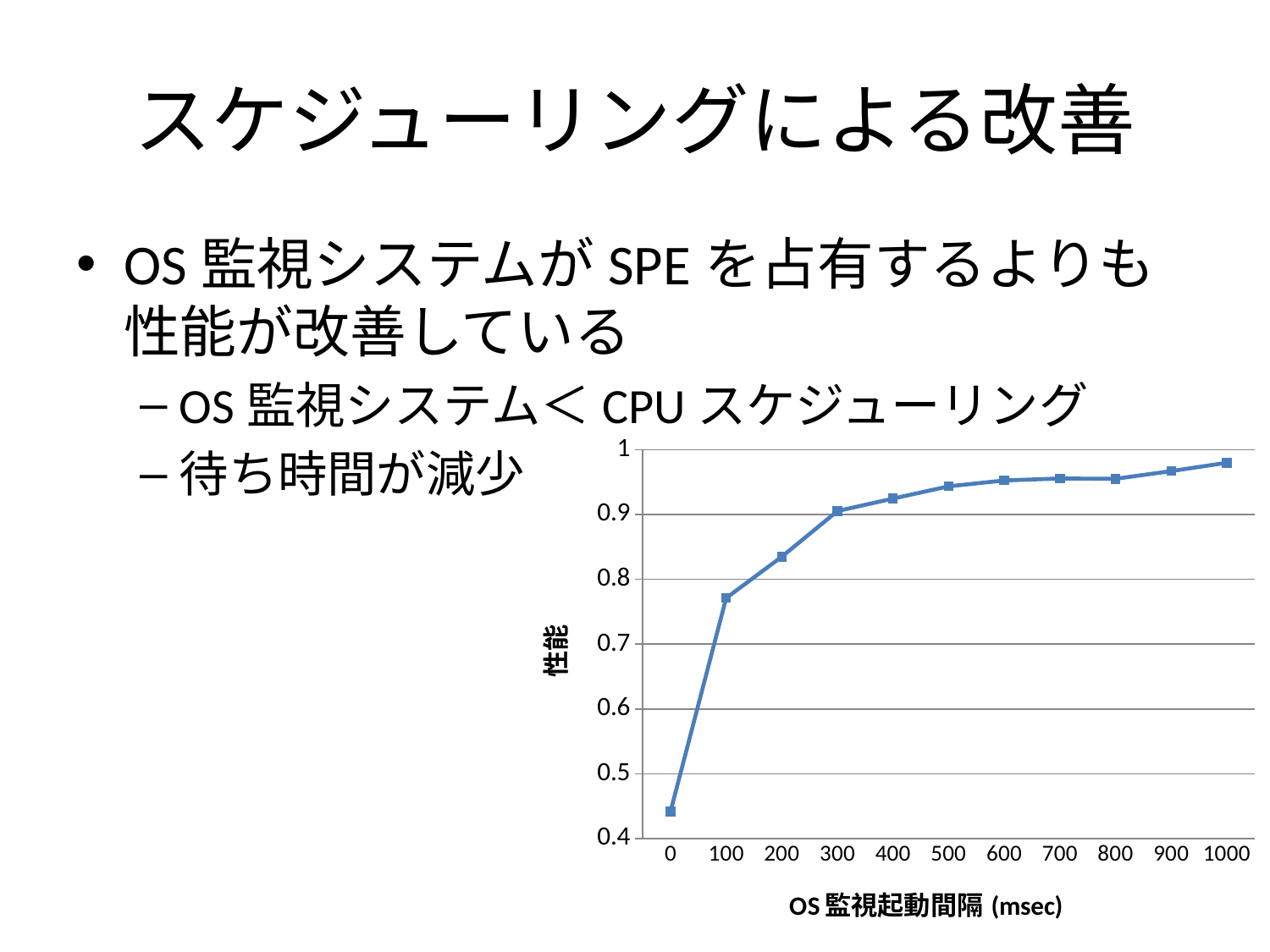
What is the label of the x axis? OS 監視起動間隔 (msec) Do the 性能 values rise or fall as OS 監視起動間隔 increases from 0 to 1000 msec? rise Which OS 監視起動間隔 value has the lowest 性能? 0 Which has the higher 性能 value: 0 msec or 100 msec? 100 msec Is the 性能 value at 0 msec greater or less than 0.5? less How many data points are plotted on the line? 11 What kind of chart is shown on the slide? line chart Is the 性能 value at 1000 msec greater or less than 0.9? greater What is the label of the y axis? 性能 Is the 性能 value at 100 msec greater or less than 0.7? greater